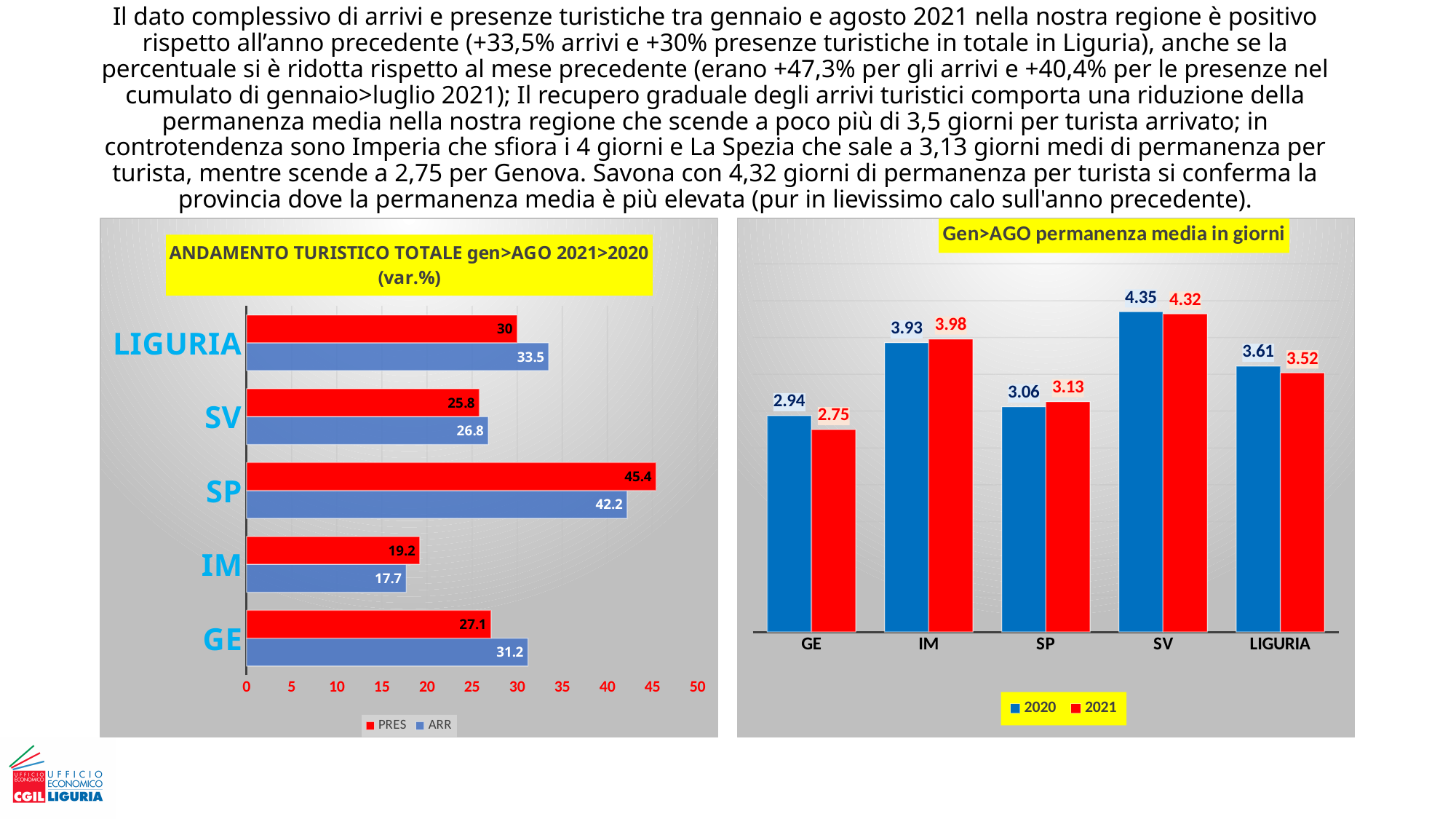
In the chart 'ANDAMENTO TURISTICO TOTALE gen>AGO 2021>2020 (var.%)', what is the ARR value for LIGURIA? 33.5 In the chart 'Gen>AGO permanenza media in giorni', what colour are the 2021 bars? Red What kind of chart is 'ANDAMENTO TURISTICO TOTALE gen>AGO 2021>2020 (var.%)'? Bar chart In the chart 'Gen>AGO permanenza media in giorni', is the 2020 value for SP larger or smaller than the 2021 value for SP? Smaller In the chart 'ANDAMENTO TURISTICO TOTALE gen>AGO 2021>2020 (var.%)', what is the PRES value for SP? 45.4 In the chart 'ANDAMENTO TURISTICO TOTALE gen>AGO 2021>2020 (var.%)', which category has the lowest ARR value? IM In the chart 'Gen>AGO permanenza media in giorni', what is the 2021 value for GE? 2.75 In the chart 'Gen>AGO permanenza media in giorni', what is the 2020 value for IM? 3.93 In the chart 'Gen>AGO permanenza media in giorni', how many categories are shown on the x axis? 5 In the chart 'ANDAMENTO TURISTICO TOTALE gen>AGO 2021>2020 (var.%)', what is the difference between the ARR and PRES values for GE? 4.1 In the chart 'ANDAMENTO TURISTICO TOTALE gen>AGO 2021>2020 (var.%)', how many series does the legend list? 2 In the chart 'Gen>AGO permanenza media in giorni', which category has the highest 2021 value? SV